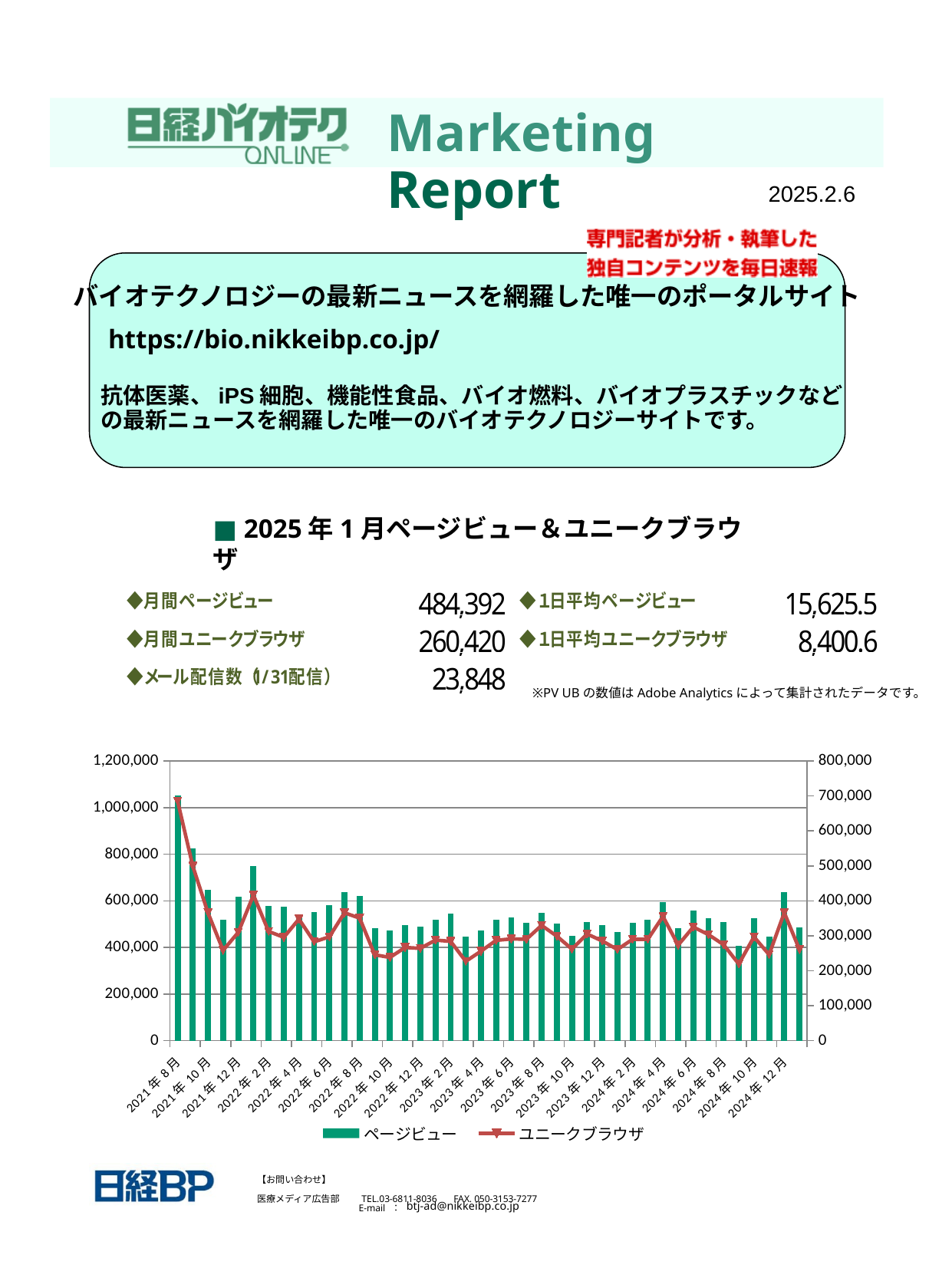
How many series does the chart legend list? 2 What are the two series named in the chart legend? ページビュー and ユニークブラウザ Which month has the larger ページビュー value, 2021年8月 or 2024年12月? 2021年8月 In which month is the ページビュー bar highest? 2021年8月 Is the ページビュー value for 2022年2月 greater or less than 600,000? less Which month has the larger ユニークブラウザ value, 2021年10月 or 2023年4月? 2021年10月 Is the ページビュー value for 2021年8月 greater or less than 800,000? greater What kind of chart is shown on the slide? A combined bar and line chart Overall, do the ページビュー values rise or fall from 2021年8月 to 2025年1月? fall Which series is drawn as bars in the chart? ページビュー Is the ユニークブラウザ value for 2021年8月 greater or less than 600,000 on the right axis? greater